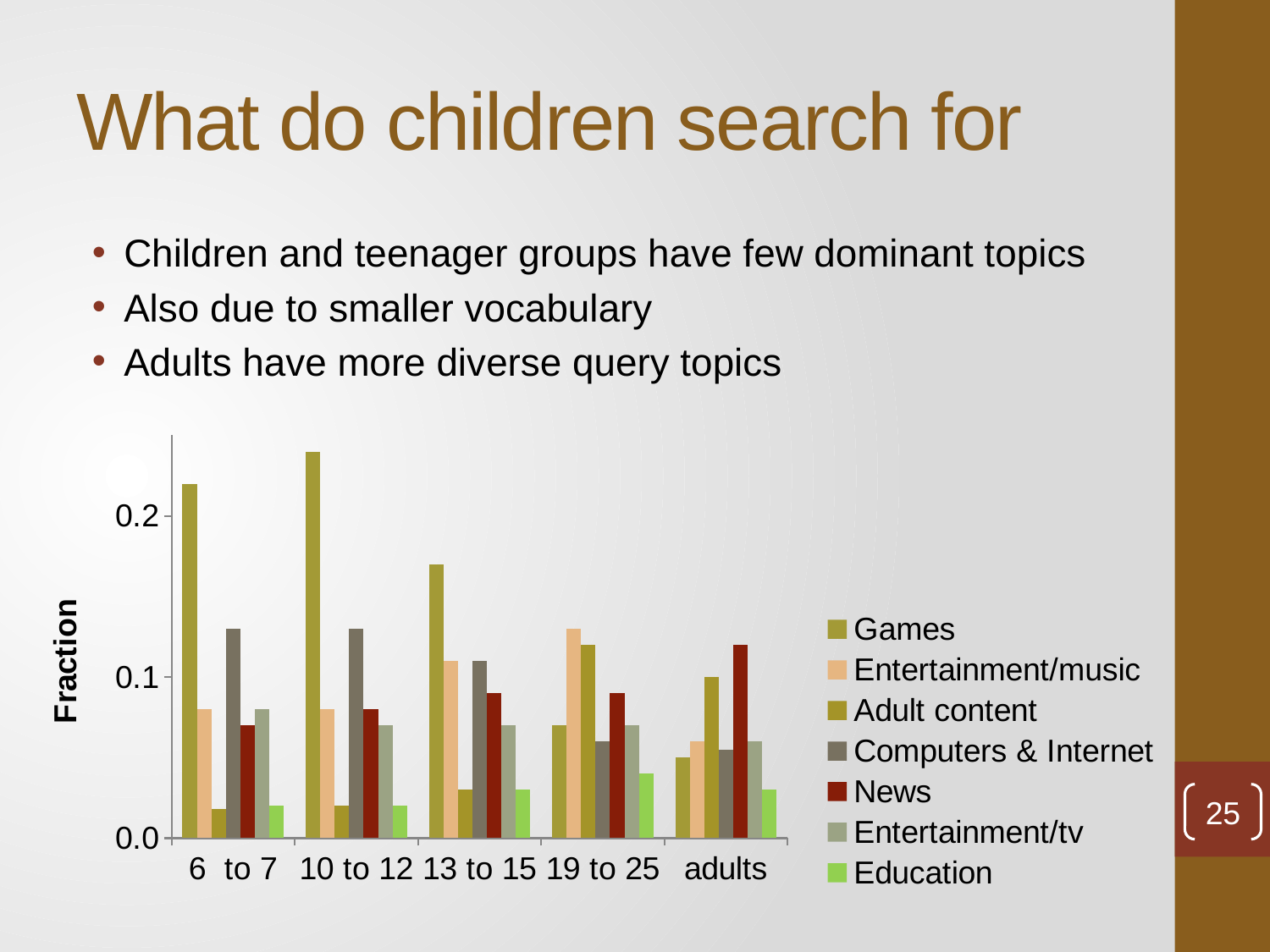
What is the label on the y axis of the chart? Fraction How many series does the chart's legend list? 7 Is the Games value for the 13 to 15 group greater or less than 0.2? less How many age groups are shown on the x axis of the chart? 5 Is the News value for adults greater or less than 0.1? greater Which series is listed first in the chart's legend? Games Which age group has the highest Games value? 10 to 12 What kind of chart is shown on the slide? bar chart Is the Education value for the 6 to 7 group greater or less than 0.1? less Which is larger: the News value for adults or the News value for the 6 to 7 group? adults Which age group has the lowest Games value? adults